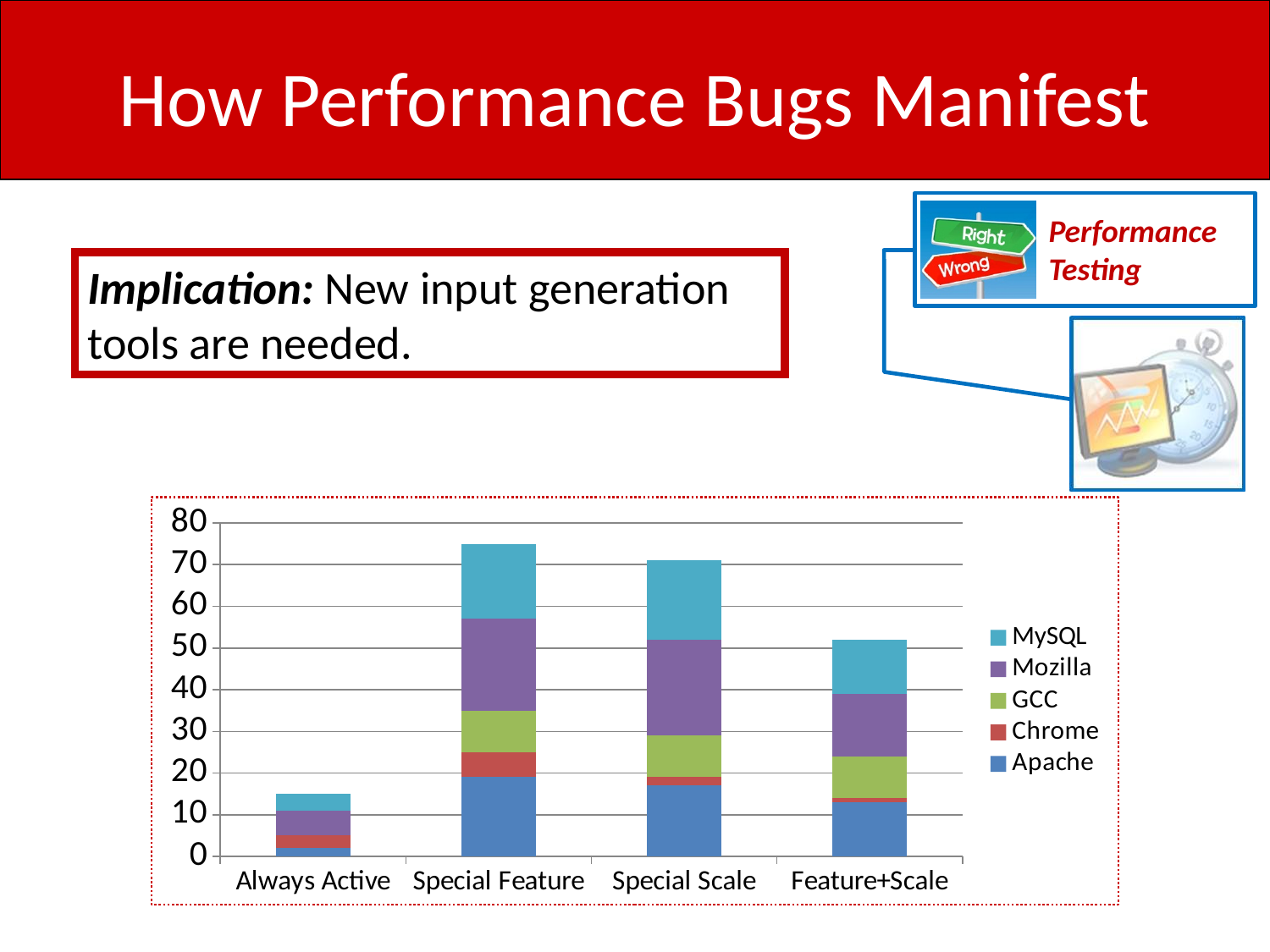
How many categories are shown on the x axis of the chart? 4 Which category has the lowest total stacked bar? Always Active Which has the larger total stacked bar, Feature+Scale or Always Active? Feature+Scale What kind of chart is shown on the slide? stacked bar chart How many series does the chart's legend list? 5 Is the total for Special Feature greater or less than 70? greater Which category has the highest total stacked bar? Special Feature Is the total for Feature+Scale greater or less than 60? less Is the total for Special Scale greater or less than 60? greater Which series is shown at the bottom of each stacked bar? Apache Which series is listed first (at the top) in the chart's legend? MySQL